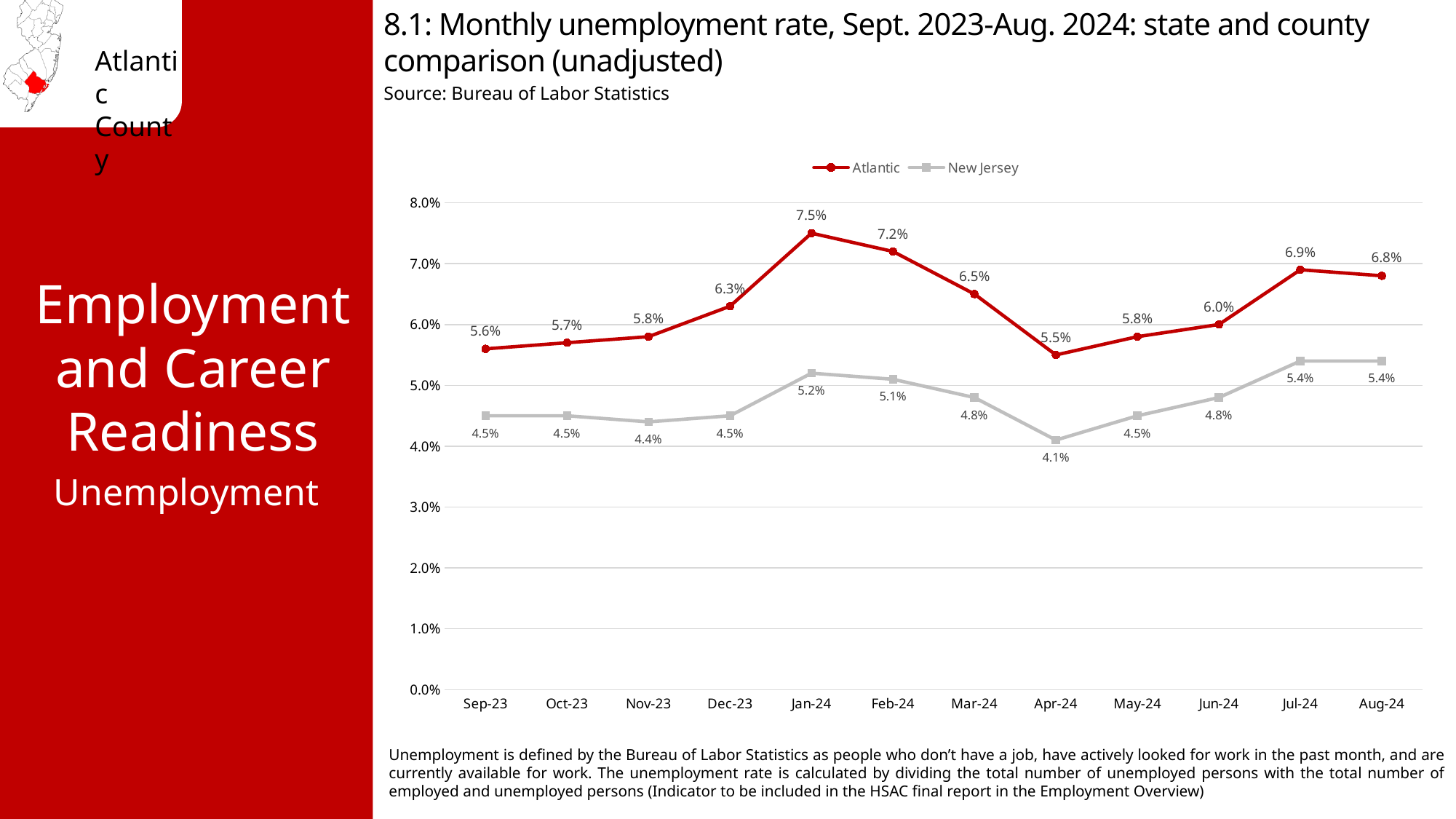
What was the New Jersey unemployment rate in Apr-24? 4.1% How many months are shown on the x axis? 12 How many series does the legend list? 2 What was the Atlantic unemployment rate in Sep-23? 5.6% Which series had the higher value in Aug-24, Atlantic or New Jersey? Atlantic What is the difference between the Atlantic and New Jersey rates in Jan-24? 2.3% What kind of chart is shown on the slide? Line chart In which month did the Atlantic series reach its highest value? Jan-24 In which month did the New Jersey series reach its lowest value? Apr-24 Did the Atlantic rate rise or fall from Jan-24 to Apr-24? Fall Is the Atlantic value for Feb-24 greater or less than 7.0%? greater What was the Atlantic unemployment rate in Jan-24? 7.5%